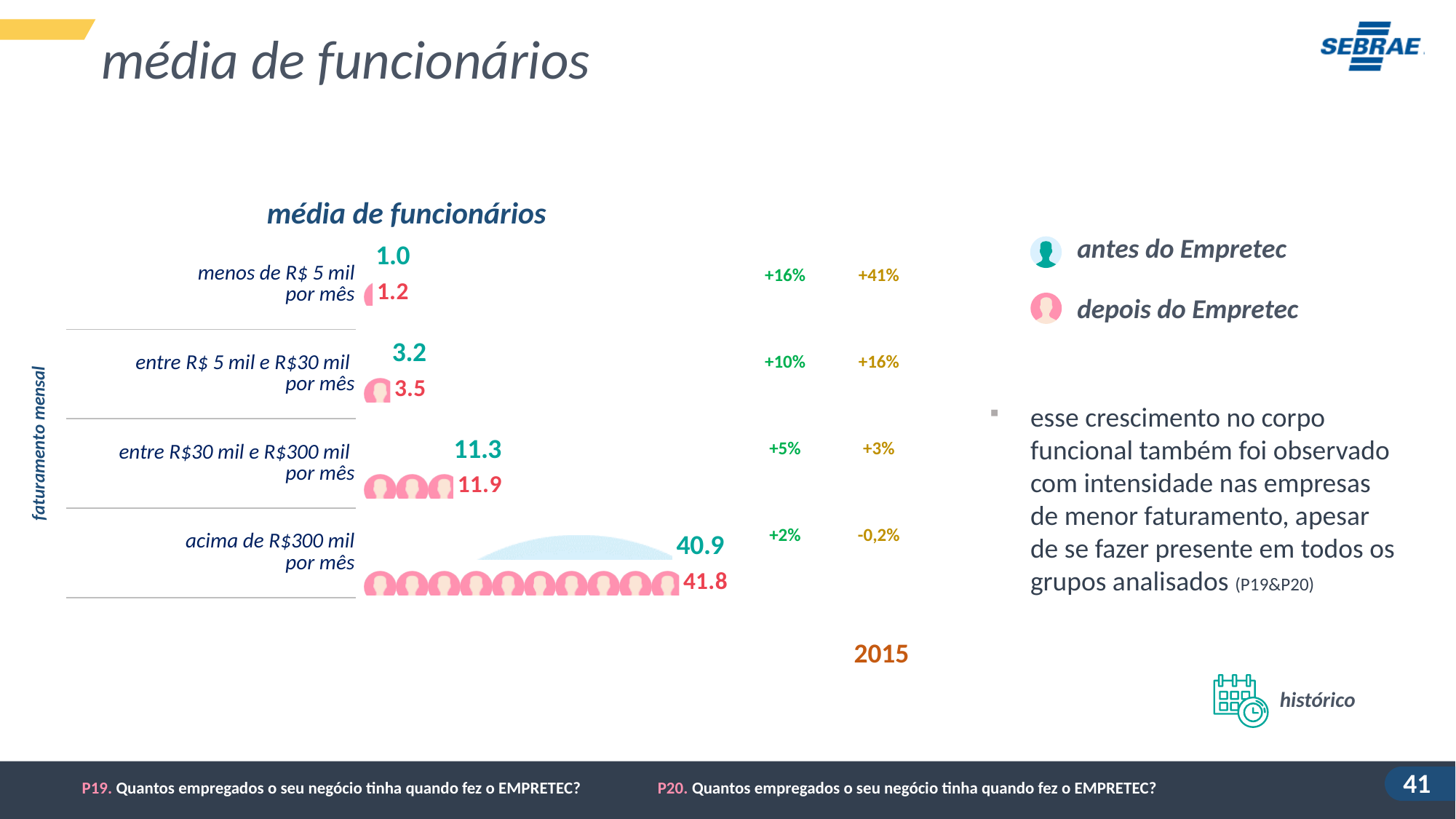
What is the title of the chart? média de funcionários How many revenue groups are shown in the chart? 4 What is the 'antes do Empretec' value for the 'entre R$30 mil e R$300 mil por mês' group? 11.3 For the 'acima de R$300 mil por mês' group, which is larger: the value before Empretec or after Empretec? depois do Empretec (41.8) How many series does the legend list? 2 What is the difference between the 'depois' and 'antes' values for the 'entre R$30 mil e R$300 mil por mês' group? 0.6 What is the average number of employees before Empretec for businesses with revenue 'menos de R$ 5 mil por mês'? 1.0 What is the 'depois do Empretec' value for the 'entre R$ 5 mil e R$30 mil por mês' group? 3.5 Which revenue group has the highest average number of employees after Empretec? acima de R$300 mil por mês Which revenue group has the lowest average number of employees before Empretec? menos de R$ 5 mil por mês What is the average number of employees after Empretec for businesses with revenue 'acima de R$300 mil por mês'? 41.8 What is the green percentage shown next to the 'menos de R$ 5 mil por mês' group? +16%